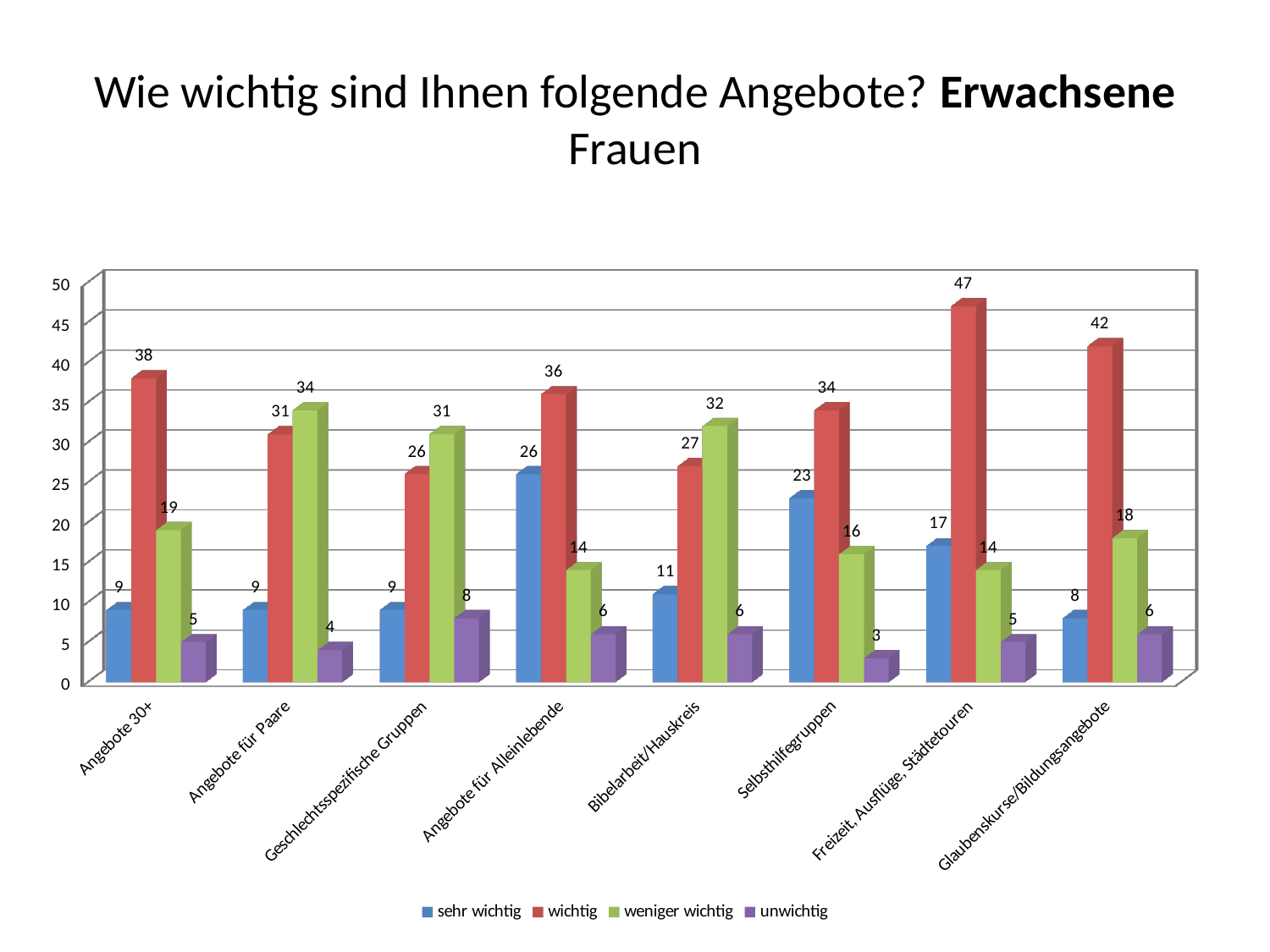
What is the value for "wichtig" for Freizeit, Ausflüge, Städtetouren? 47 What kind of chart is shown on the slide? Bar chart What is the value for "weniger wichtig" for Bibelarbeit/Hauskreis? 32 Which category has the highest value for "wichtig"? Freizeit, Ausflüge, Städtetouren What is the value for "unwichtig" for Geschlechtsspezifische Gruppen? 8 Which category has the lowest value for "unwichtig"? Selbsthilfegruppen How many categories are shown on the x axis? 8 What is the value for "sehr wichtig" for Angebote für Alleinlebende? 26 Which is larger for Angebote für Paare: "wichtig" or "weniger wichtig"? weniger wichtig Which series is shown in green in the legend? weniger wichtig How many series does the legend list? 4 What is the difference between the "wichtig" values for Glaubenskurse/Bildungsangebote and Angebote 30+? 4